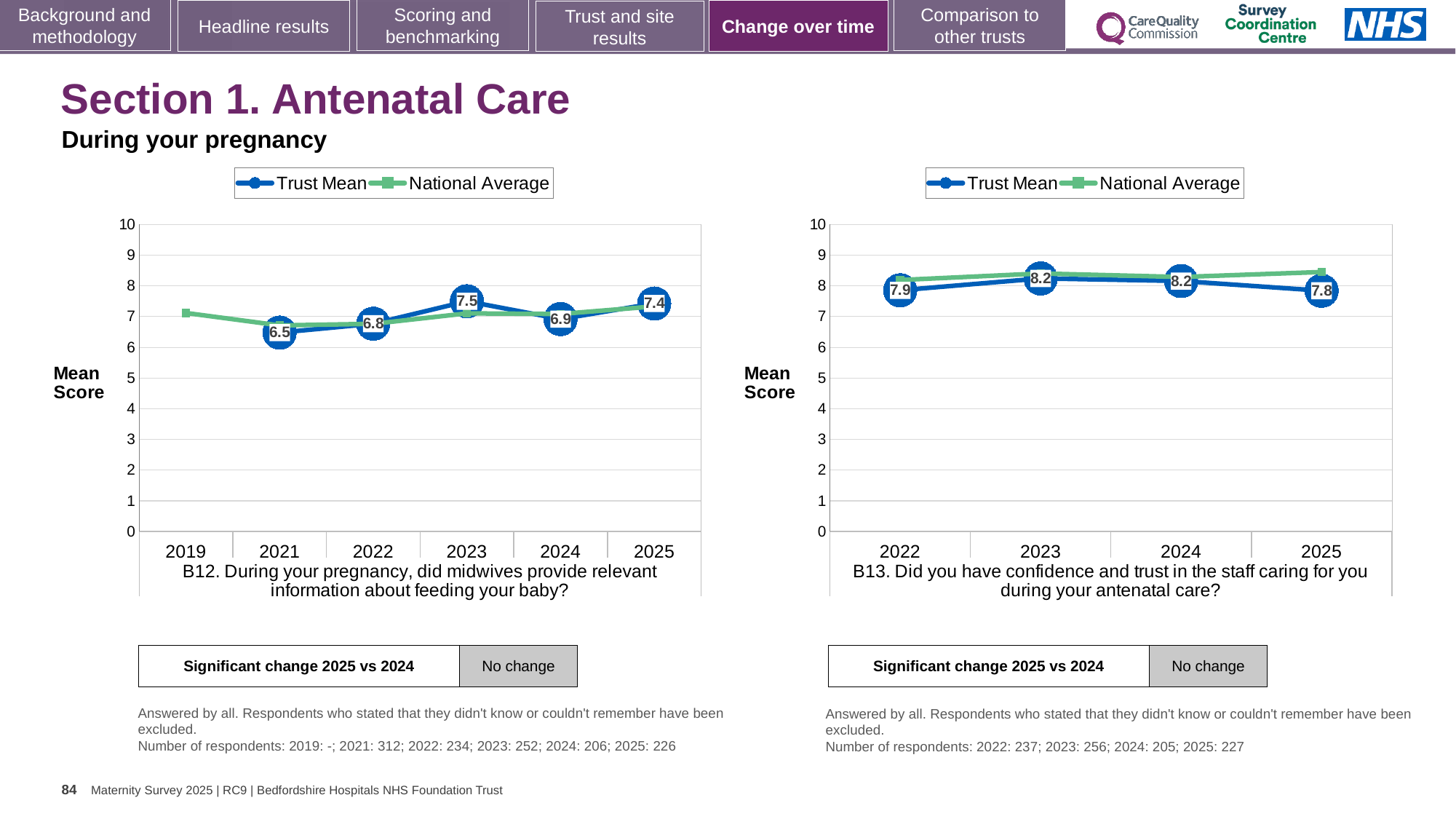
How many series does the legend of the B12 chart (left) list? 2 In the B13 chart (right), what is the difference between the Trust Mean scores for 2023 and 2025? 0.4 In the B13 chart (right), which year has the lowest Trust Mean score? 2025 In the B13 chart (right), is the National Average for 2025 greater or less than 8? greater In the B12 chart (left), which year has the lowest Trust Mean score? 2021 In the B12 chart (left), which year has the highest Trust Mean score? 2023 In the B13 chart (right), what is the Trust Mean score for 2022? 7.9 In the B12 chart (left), is the Trust Mean score higher in 2024 or 2025? 2025 In the B12 chart (left), what is the Trust Mean score for 2023? 7.5 In the B12 chart (left), what is the difference between the Trust Mean scores for 2023 and 2021? 1.0 How many years are shown on the x axis of the B13 chart (right)? 4 In the B12 chart (left), what is the Trust Mean score for 2025? 7.4